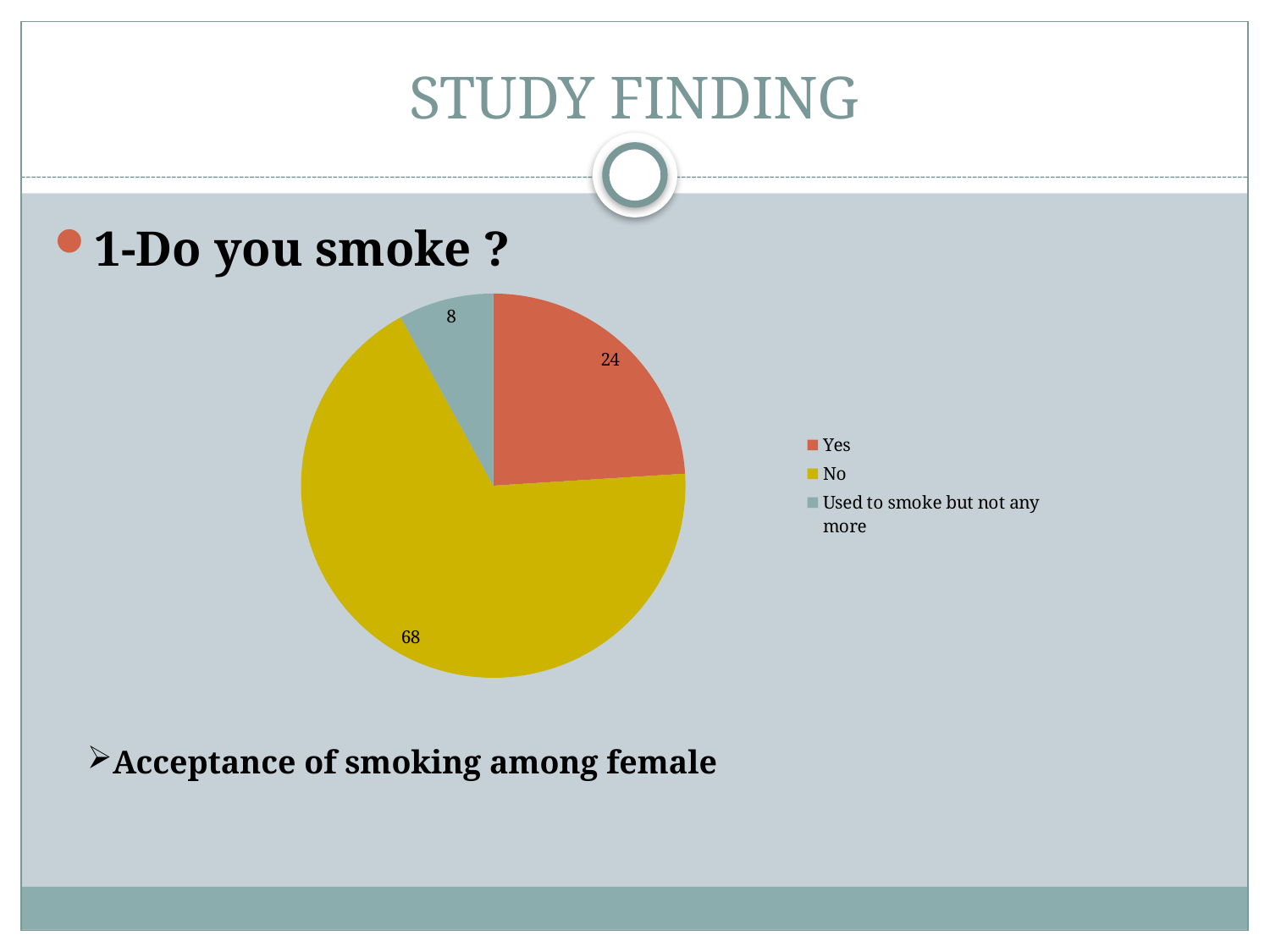
What value is shown for the "Yes" slice of the pie chart? 24 What is the difference between the "No" value and the "Yes" value in the pie chart? 44 What is the total of all the values shown in the pie chart? 100 Which is larger in the pie chart, the "Yes" value or the "Used to smoke but not any more" value? Yes What kind of chart is shown on the slide? Pie chart How many entries does the legend of the pie chart list? 3 What value is shown for the "No" slice of the pie chart? 68 Which category has the smallest slice in the pie chart? Used to smoke but not any more What value is shown for the "Used to smoke but not any more" slice of the pie chart? 8 How many slices does the pie chart have? 3 Which category has the largest slice in the pie chart? No What colour is the "No" slice in the pie chart? Yellow